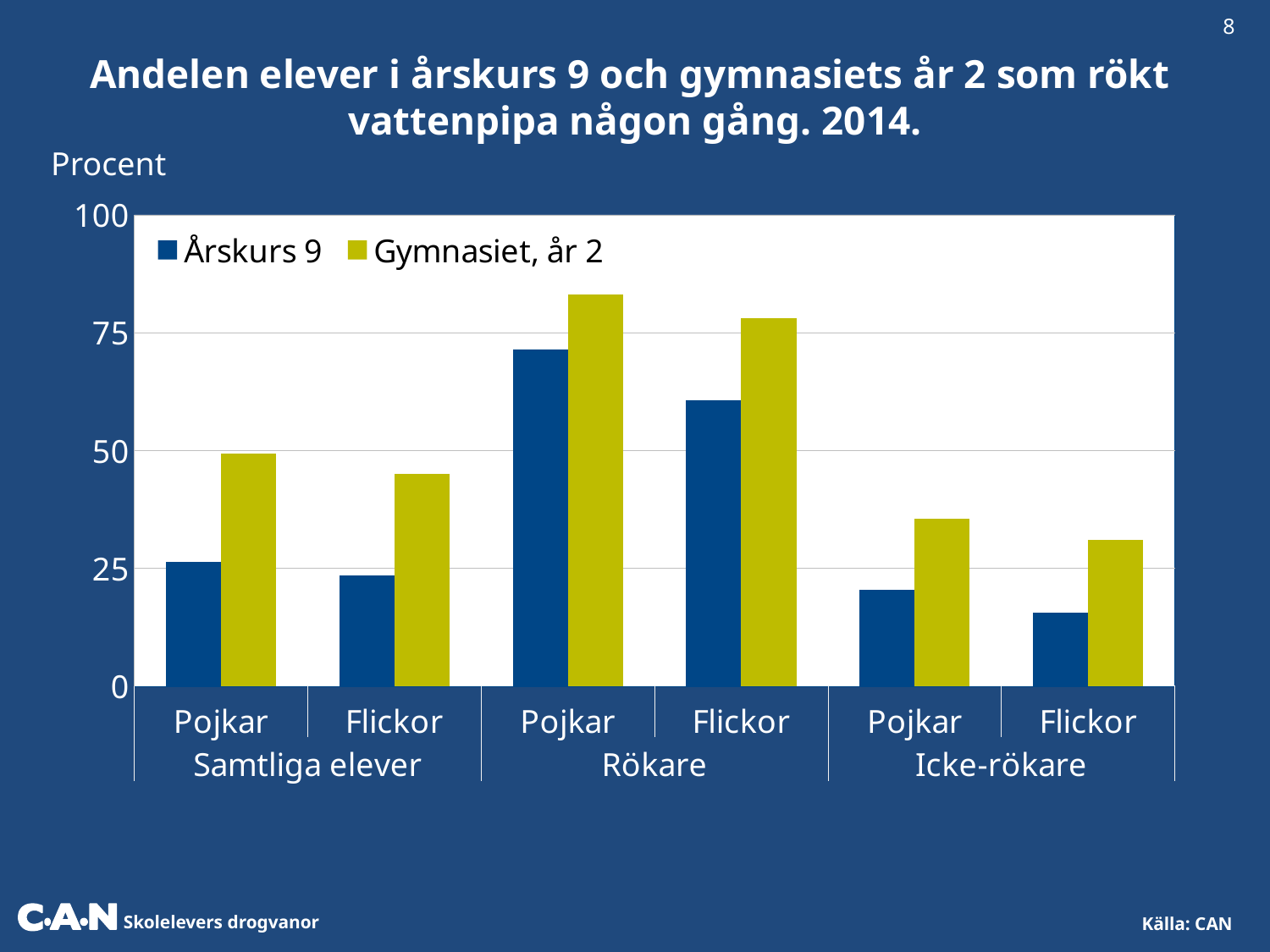
Is the Gymnasiet, år 2 value for Flickor among Icke-rökare greater or less than 25? greater Is the Gymnasiet, år 2 value for Flickor among Samtliga elever greater or less than 50? less Which bar is the highest in the chart? Gymnasiet, år 2 for Pojkar among Rökare Is the Årskurs 9 value for Pojkar among Icke-rökare greater or less than 25? less How many series does the legend list? 2 Which bar is the lowest in the chart? Årskurs 9 for Flickor among Icke-rökare What kind of chart is shown on the slide? bar chart Among Icke-rökare, which is larger for Gymnasiet, år 2: the value for Pojkar or for Flickor? Pojkar Among Rökare, which is larger for Årskurs 9: the value for Pojkar or for Flickor? Pojkar What unit label is shown above the y axis? Procent How many category groups (Pojkar/Flickor pairs) are shown along the x axis? 3